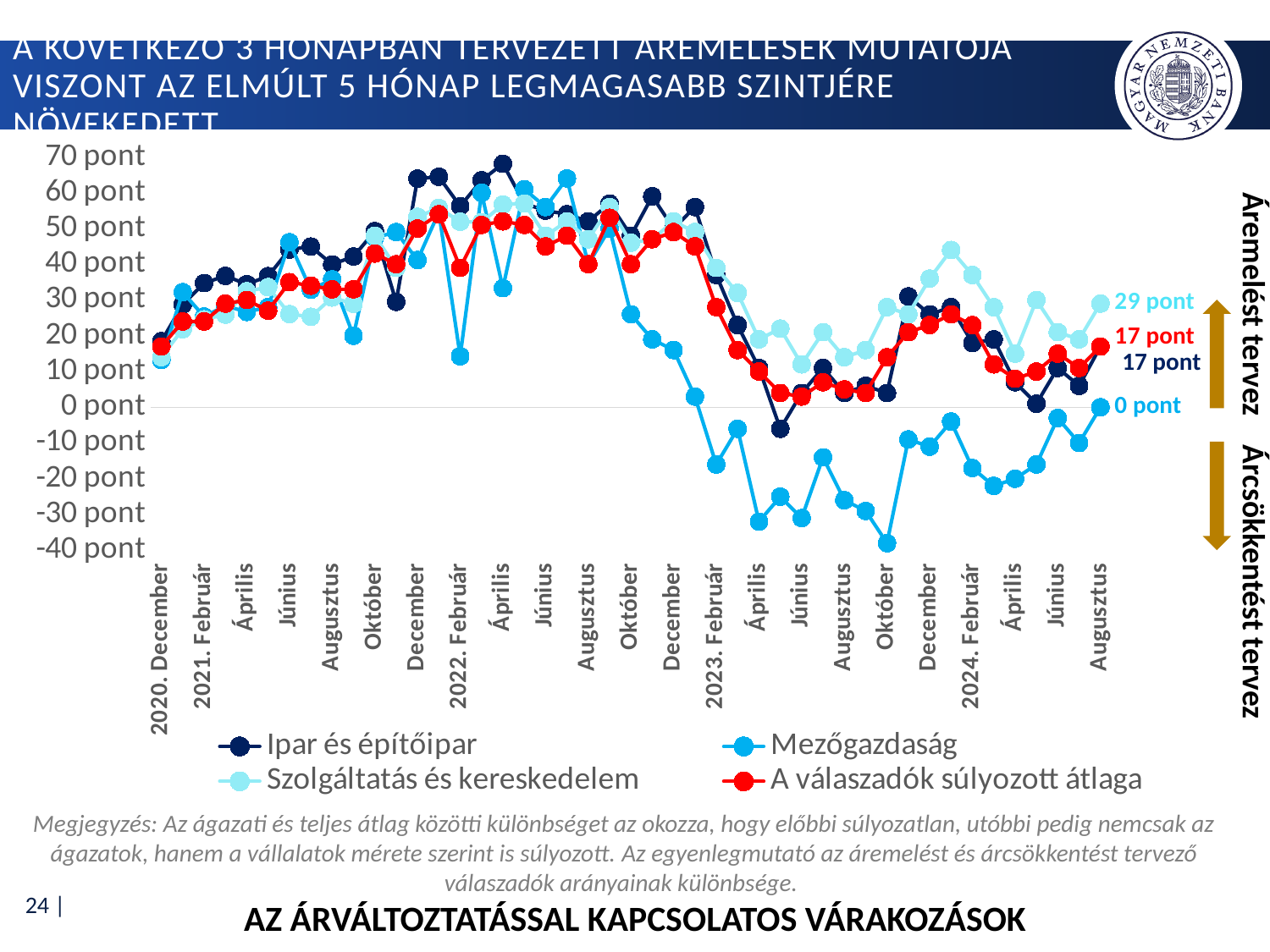
Which series has the lowest value at 2024 Augusztus? Mezőgazdaság What is the difference between the final values of Szolgáltatás és kereskedelem and Mezőgazdaság? 29 pont What is the value for Mezőgazdaság at the end of the series (2024 Augusztus)? 0 pont At 2024 Augusztus, which is larger: Szolgáltatás és kereskedelem or Mezőgazdaság? Szolgáltatás és kereskedelem What is the value for Ipar és építőipar at the end of the series (2024 Augusztus)? 17 pont Is the value for Mezőgazdaság in 2023 Április greater or less than -20 pont? less What is the value for Szolgáltatás és kereskedelem at the end of the series (2024 Augusztus)? 29 pont What is the value for A válaszadók súlyozott átlaga at the end of the series (2024 Augusztus)? 17 pont What kind of chart is shown on the slide? line chart How many series does the legend list? 4 What is the difference between the final values of Szolgáltatás és kereskedelem and Ipar és építőipar? 12 pont Which colour is used for the line A válaszadók súlyozott átlaga? red